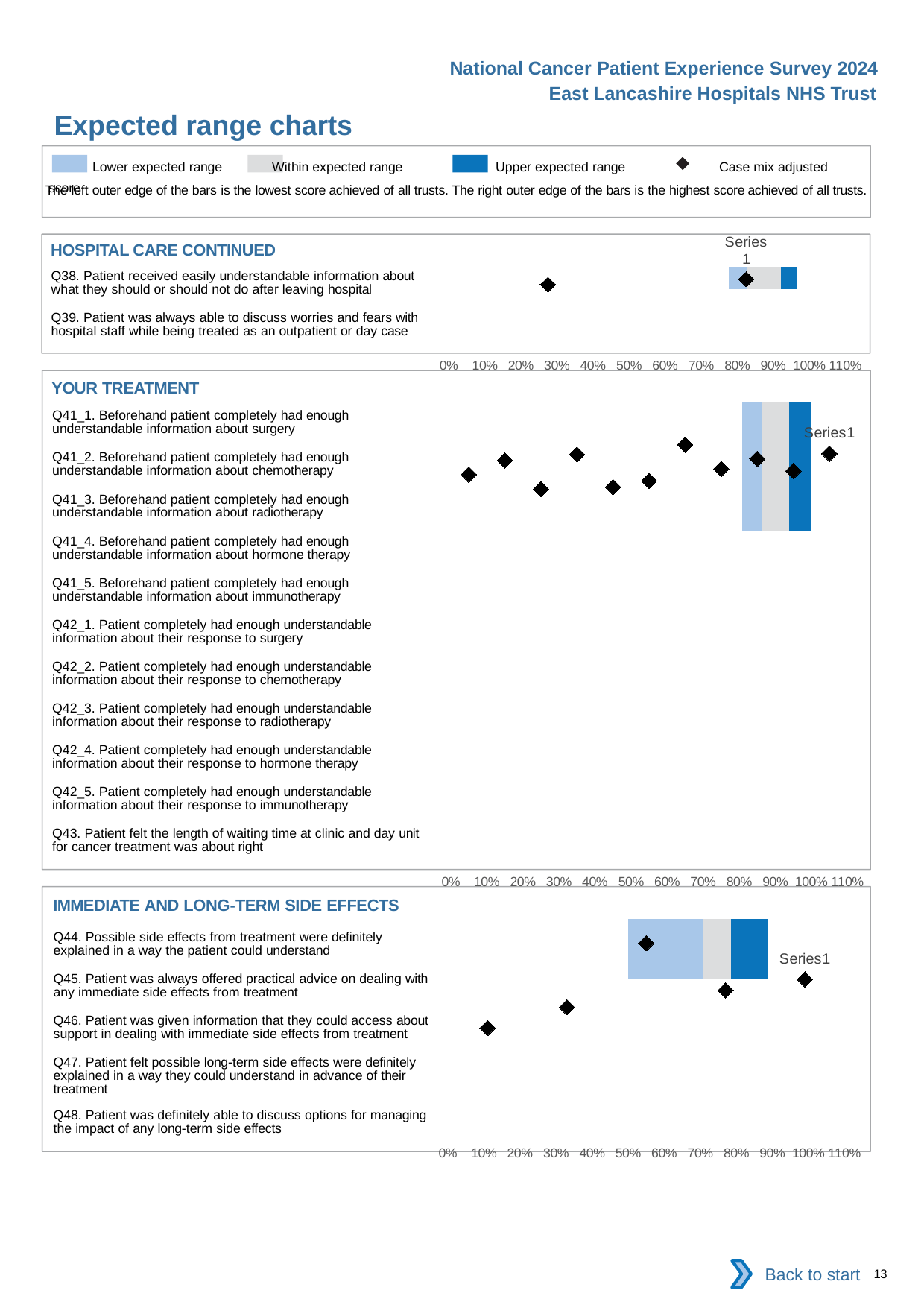
In the Your Treatment chart, is the left edge of the shaded expected range bar greater or less than 70%? greater What is the title of the slide? Expected range charts In the Immediate and Long-term Side Effects chart, is the right edge of the shaded expected range bar greater or less than 80%? greater What is the lowest tick shown on the x axis of the Immediate and Long-term Side Effects chart? 0% How many entries does the legend at the top of the slide list? 4 In the Hospital Care Continued chart, is the right edge of the shaded expected range bar greater or less than 90%? greater What is the highest tick shown on the x axis of the Your Treatment chart? 110% How many questions are listed in the Your Treatment chart? 11 According to the legend, what does the black diamond marker represent? Case mix adjusted score How many questions are listed in the Hospital Care Continued chart? 2 How many questions are listed in the Immediate and Long-term Side Effects chart? 5